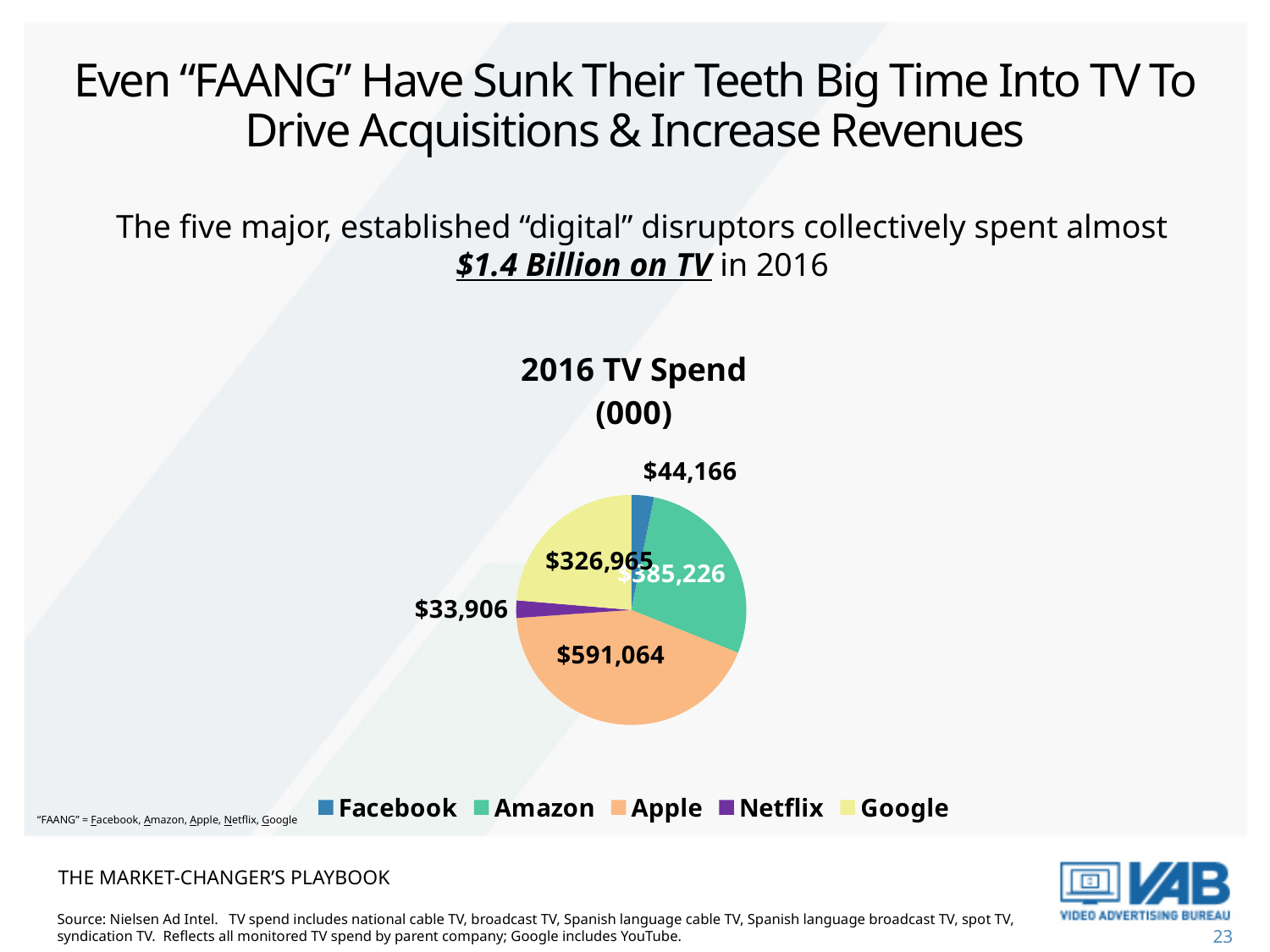
What is the 2016 TV spend value shown for Facebook? $44,166 What is the title of the chart? 2016 TV Spend (000) What is the difference between Apple's and Amazon's 2016 TV spend values? $205,838 Which colour represents Google in the pie chart? Yellow What is the 2016 TV spend value shown for Netflix? $33,906 What is the 2016 TV spend value shown for Apple? $591,064 How many companies does the legend list? 5 What type of chart is shown on the slide? Pie chart Which company has the largest slice of the pie? Apple What is the 2016 TV spend value shown for Google? $326,965 Which company has the smallest slice of the pie? Netflix Which company spent more on TV in 2016, Amazon or Google? Amazon